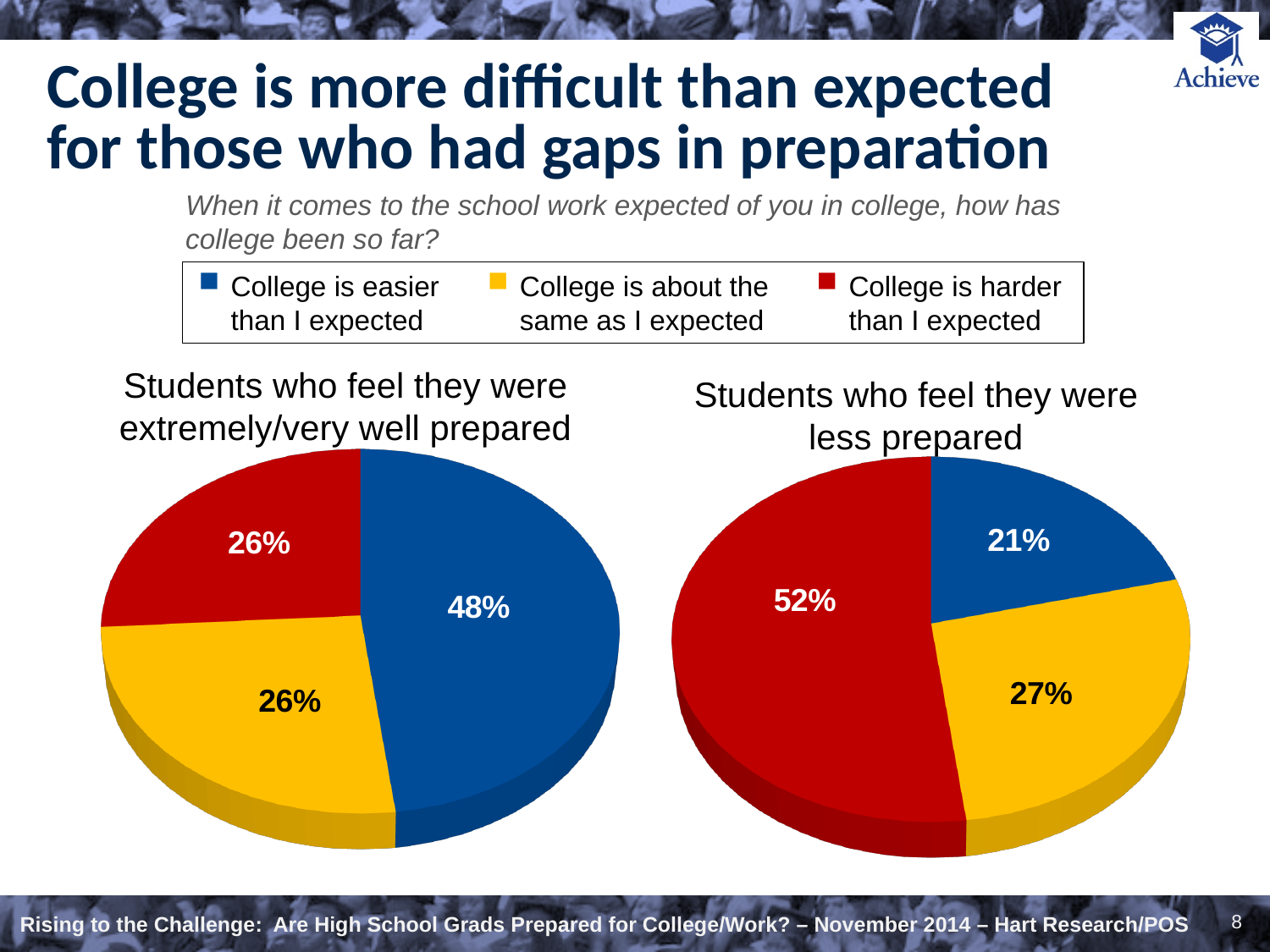
In the 'Students who feel they were extremely/very well prepared' pie chart, what percentage said college is harder than they expected? 26% In the 'Students who feel they were extremely/very well prepared' pie chart, what percentage said college is easier than they expected? 48% What colour represents 'College is harder than I expected' in the pie charts? Red In the 'Students who feel they were less prepared' pie chart, what percentage said college is harder than they expected? 52% In the 'Students who feel they were less prepared' pie chart, which response has the largest share? College is harder than I expected In the 'Students who feel they were extremely/very well prepared' pie chart, which response has the largest share? College is easier than I expected Which group has a larger share saying college is easier than expected: extremely/very well prepared students or less prepared students? Extremely/very well prepared students In the 'Students who feel they were less prepared' pie chart, what percentage said college is about the same as they expected? 27% What type of chart is used on this slide? Pie chart What is the difference between the share saying college is harder than expected among less prepared students and among extremely/very well prepared students? 26 percentage points In the 'Students who feel they were less prepared' pie chart, which response has the smallest share? College is easier than I expected How many response categories does the legend list? 3